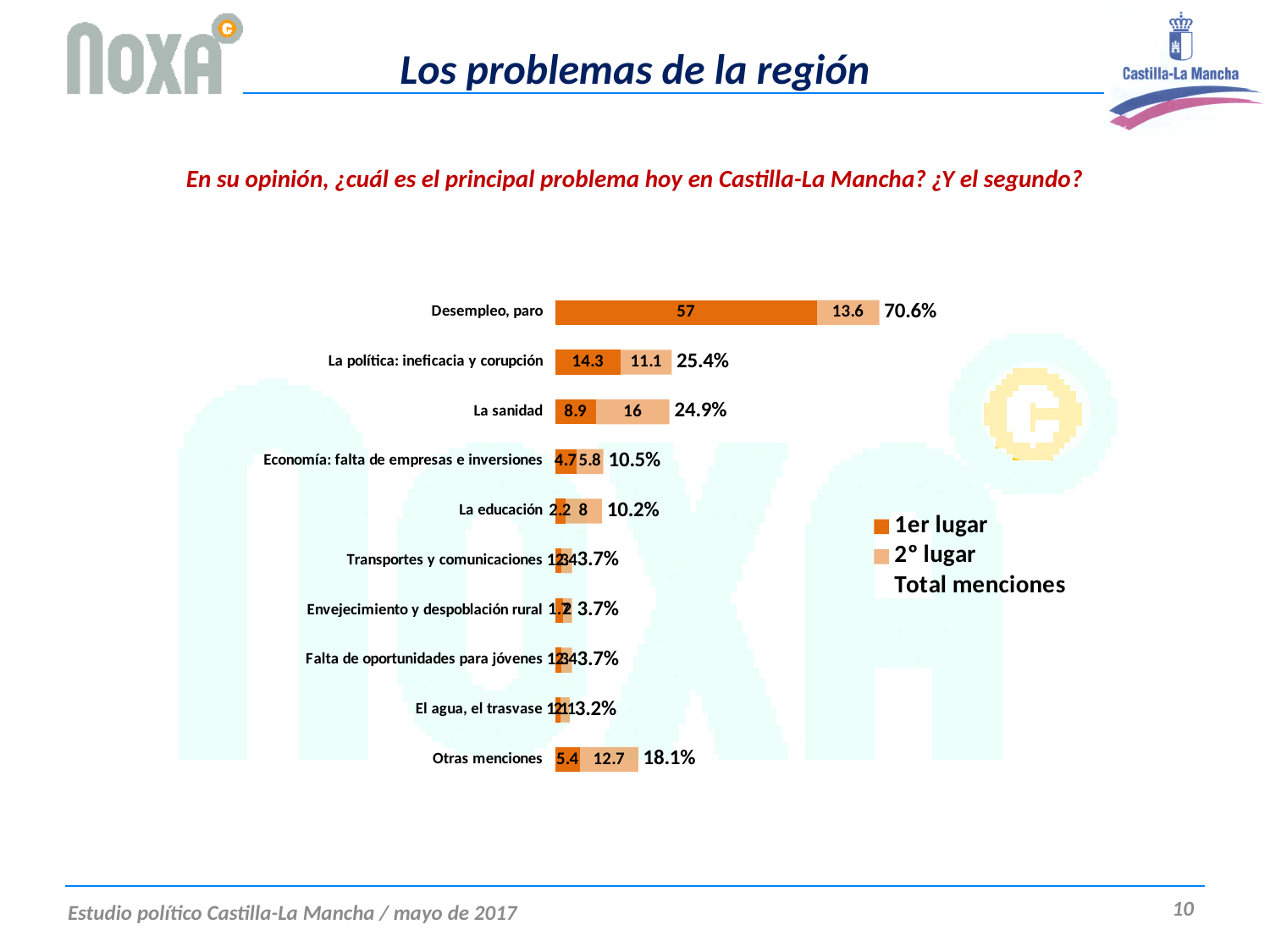
What is the '2° lugar' value for 'La sanidad'? 16 Which category has the lowest total mentions percentage? El agua, el trasvase How many entries does the chart legend list? 3 How many categories (problems) are listed in the chart? 10 Which category has the highest total mentions? Desempleo, paro What is the total of the stacked bar for 'Desempleo, paro'? 70.6% What is the total mentions percentage for 'Otras menciones'? 18.1% What is the total mentions percentage for 'La política: ineficacia y corupción'? 25.4% What is the difference between the '1er lugar' values for 'Desempleo, paro' and 'La política: ineficacia y corupción'? 42.7 Which has a larger '2° lugar' value, 'La sanidad' or 'La política: ineficacia y corupción'? La sanidad What is the '1er lugar' value for 'Desempleo, paro'? 57 What kind of chart is shown on the slide? bar chart